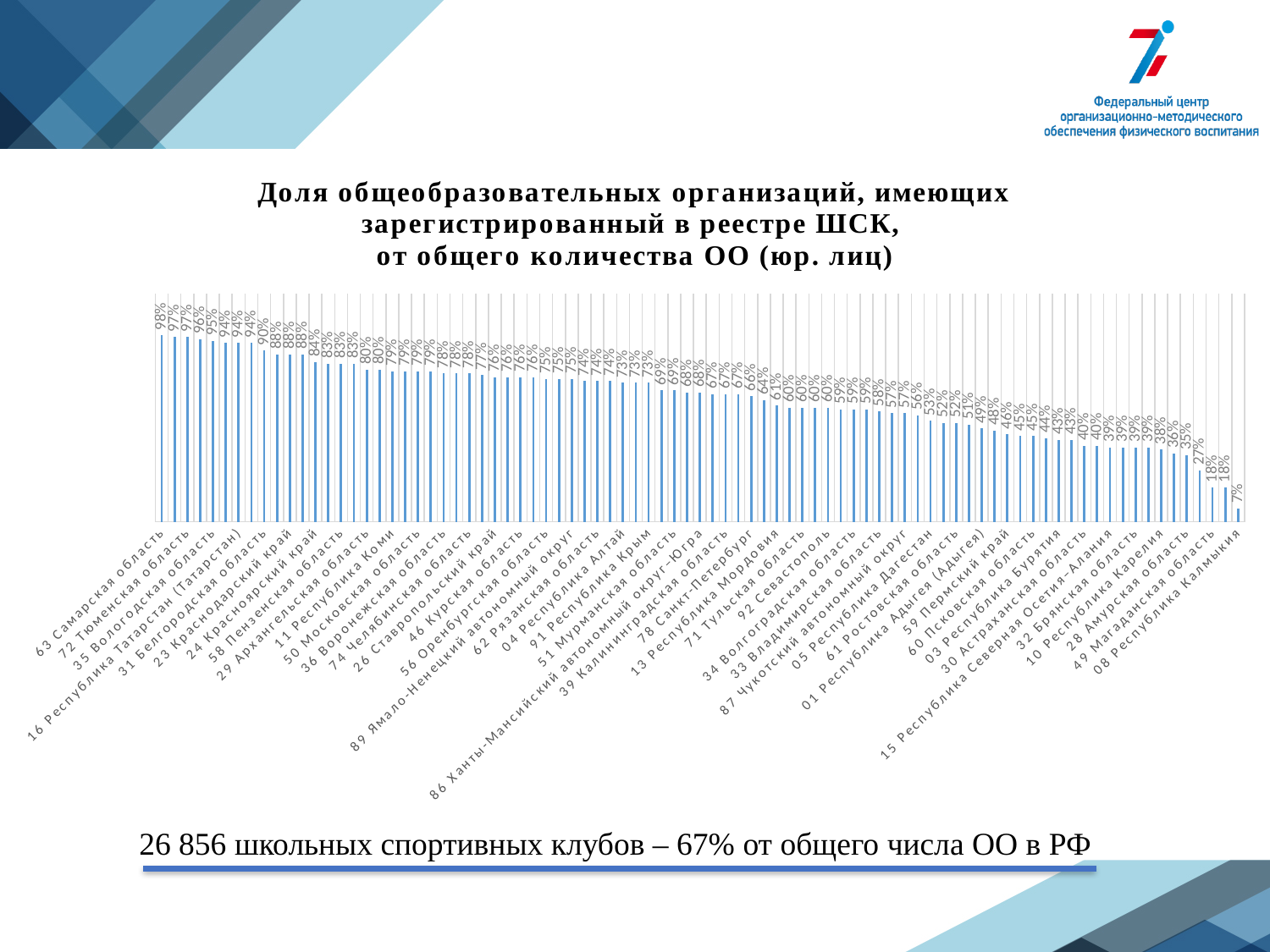
What is the title of the chart? Доля общеобразовательных организаций, имеющих зарегистрированный в реестре ШСК, от общего количества ОО (юр. лиц) Is the value for 63 Самарская область greater or less than 90%? greater What is the lowest value shown in the chart? 7% What is the highest value shown in the chart? 98% Which region has the highest share in the chart? 63 Самарская область What is the value shown for 63 Самарская область? 98% According to the text below the chart, what share of all ОО in the РФ do the 26 856 school sports clubs represent? 67% What is the difference between the highest value (98%) and the lowest value (7%) in the chart? 91 percentage points Do the values rise or fall from left to right along the x axis? Fall Which region has the lowest share in the chart? 08 Республика Калмыкия Which has a larger value: 63 Самарская область or 08 Республика Калмыкия? 63 Самарская область What kind of chart is shown on the slide? Bar chart